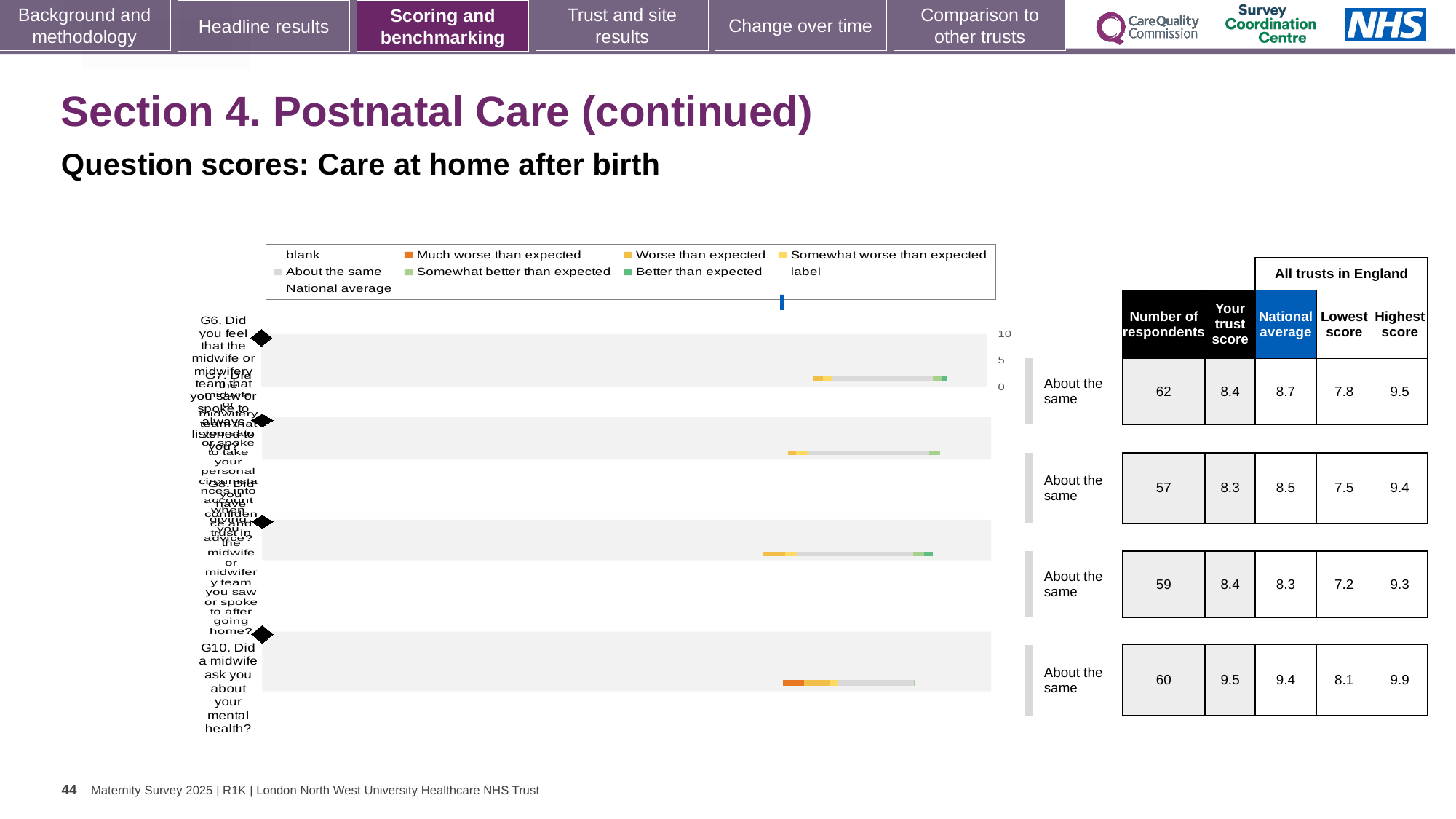
What benchmark rating is shown next to each of the four question bars? About the same In the table beside the chart, how many respondents are listed for G10 'Did a midwife ask you about your mental health?' 60 How many question bars are plotted in the chart? 4 In the table beside the chart, what is the highest score among all trusts in England for G10 'Did a midwife ask you about your mental health?' 9.9 What is the highest 'Your trust score' value shown in the table beside the chart? 9.5 In the table beside the chart, what is 'Your trust score' for G10 'Did a midwife ask you about your mental health?' 9.5 What is the smallest value in the 'Lowest score' column of the table beside the chart? 7.2 What colour does the legend use for 'Much worse than expected'? orange For G10 'Did a midwife ask you about your mental health?', what is the difference between the highest score and the lowest score among all trusts in England? 1.8 In the table beside the chart, what is the national average for G10 'Did a midwife ask you about your mental health?' 9.4 For G10 'Did a midwife ask you about your mental health?', which is larger: the trust score or the national average? the trust score What kind of chart is shown on the slide? bar chart